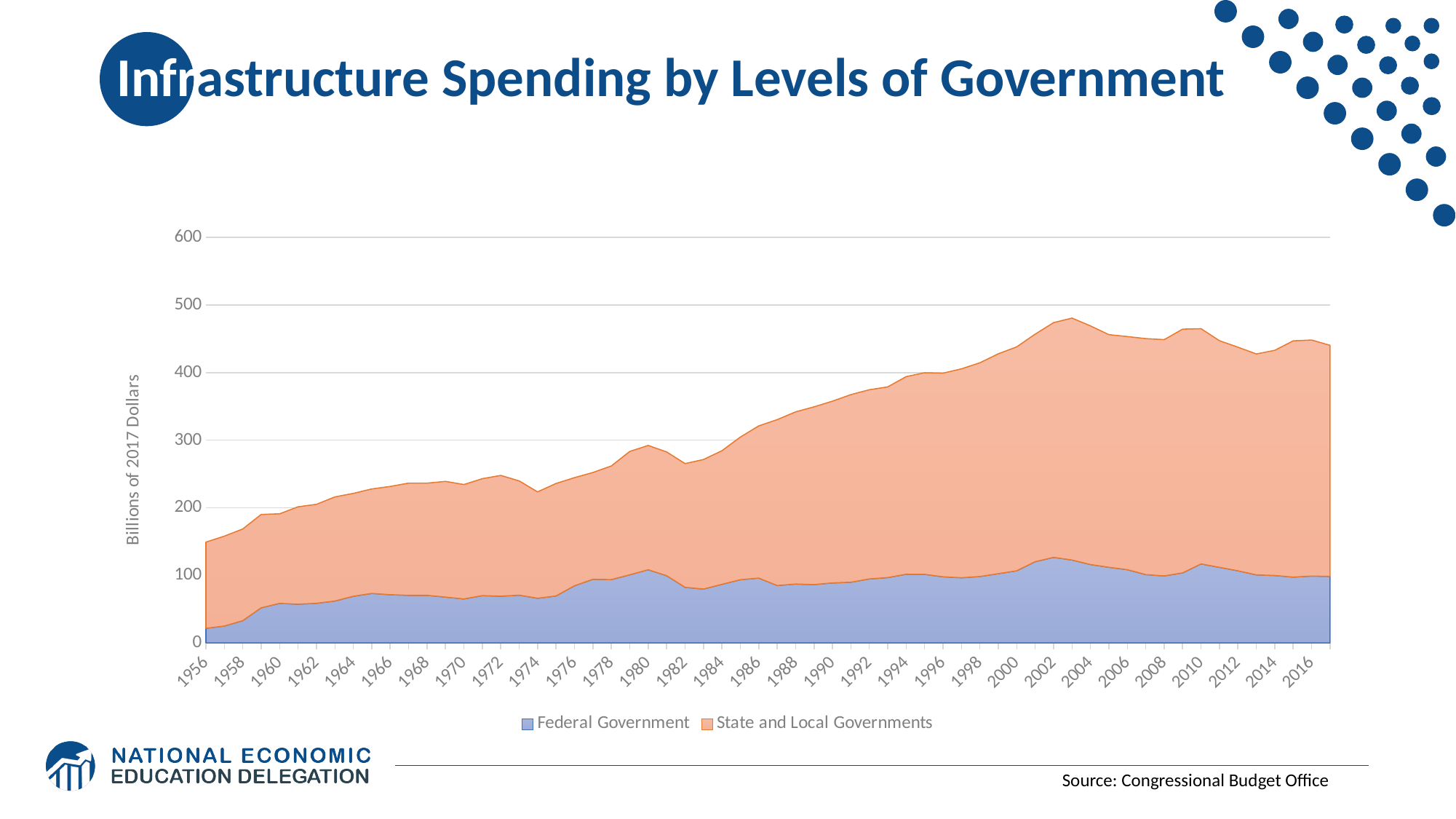
Does total infrastructure spending generally rise or fall from 1956 to 2016? rise How many year labels are shown on the x axis? 31 Is the Federal Government value in 2002 greater or less than 100? greater Is the total infrastructure spending in 1956 greater or less than 200? less What is the label on the vertical axis? Billions of 2017 Dollars Is the Federal Government value in 1956 greater or less than 100? less What kind of chart is shown on the slide? Stacked area chart How many series does the legend list? 2 What are the two series named in the legend? Federal Government; State and Local Governments In 2016, which series accounts for the larger share of spending, Federal Government or State and Local Governments? State and Local Governments